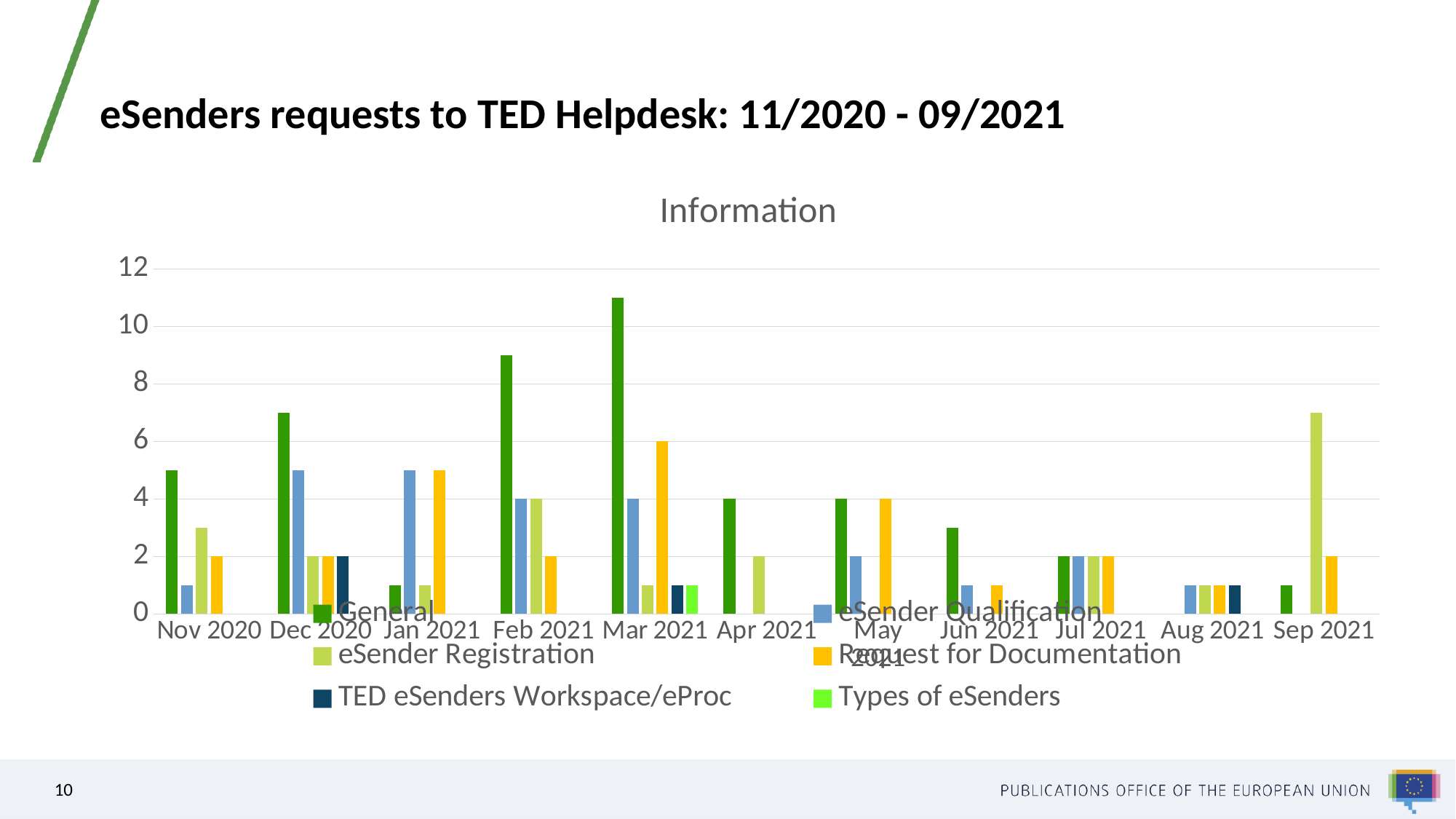
Is the value for eSender Registration in Sep 2021 greater or less than 6? greater What is the title of the chart? Information What is the difference between Request for Documentation in Mar 2021 and in Feb 2021? 4 What is the value for Request for Documentation in Mar 2021? 6 In which month is the General series highest? Mar 2021 How many series does the legend list? 6 How many months are shown on the x axis? 11 What kind of chart is shown on the slide? bar chart What is the value for General in Apr 2021? 4 What is the value for eSender Qualification in Feb 2021? 4 Which is larger, the General value in Feb 2021 or the General value in Mar 2021? Mar 2021 Is the value for General in Mar 2021 greater or less than 10? greater